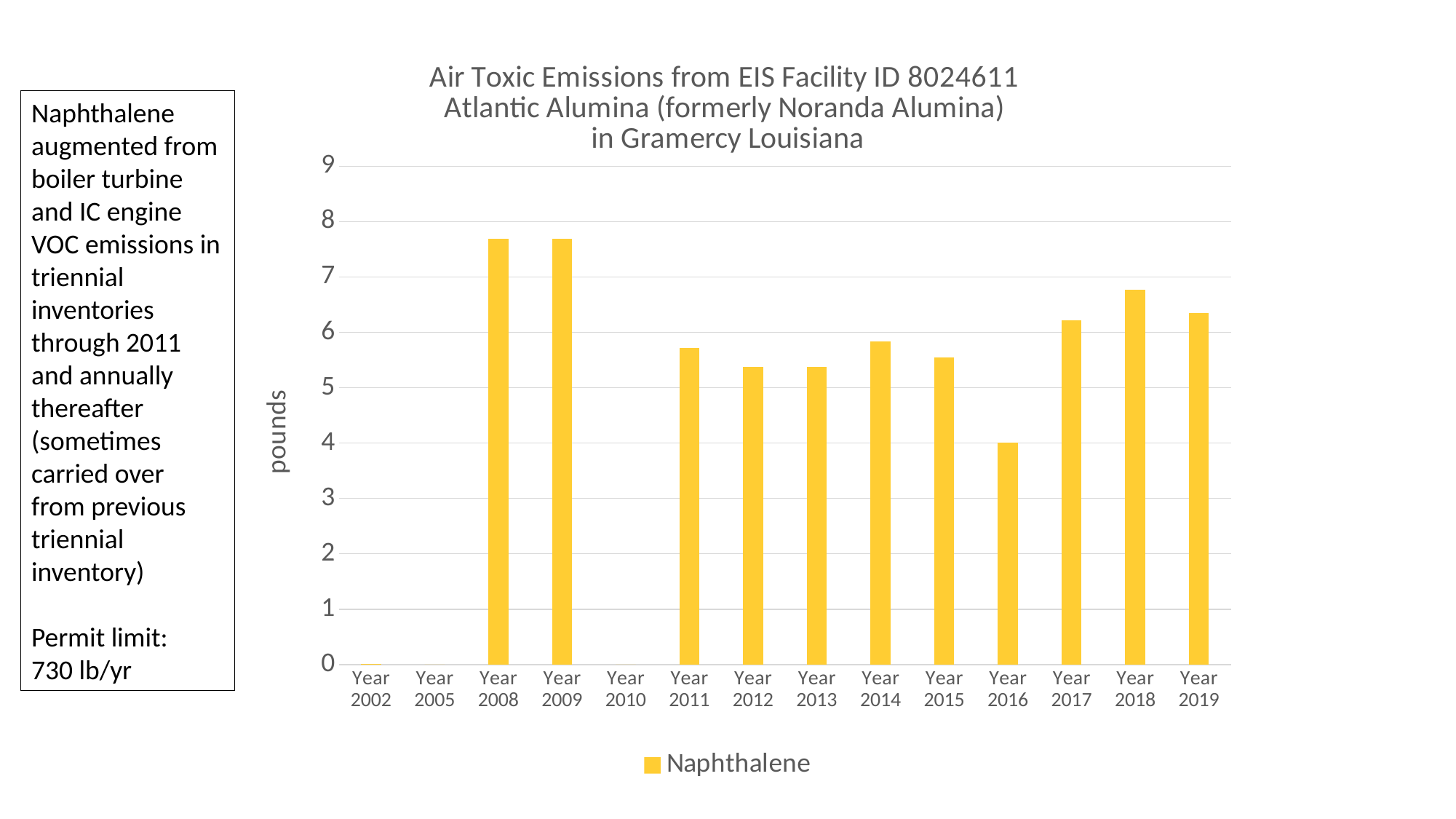
Which has the larger value, Year 2018 or Year 2019? Year 2018 Is the value for Year 2016 greater or less than 5? less What is the label on the vertical axis? pounds What series name appears in the legend? Naphthalene Is the value for Year 2018 greater or less than 6? greater Is the value for Year 2011 greater or less than 6? less What kind of chart is shown on the slide? bar chart Among the years from 2011 to 2019, which year has the lowest value? Year 2016 Which has the larger value, Year 2014 or Year 2015? Year 2014 How many year categories are shown on the x axis? 14 How many series does the legend list? 1